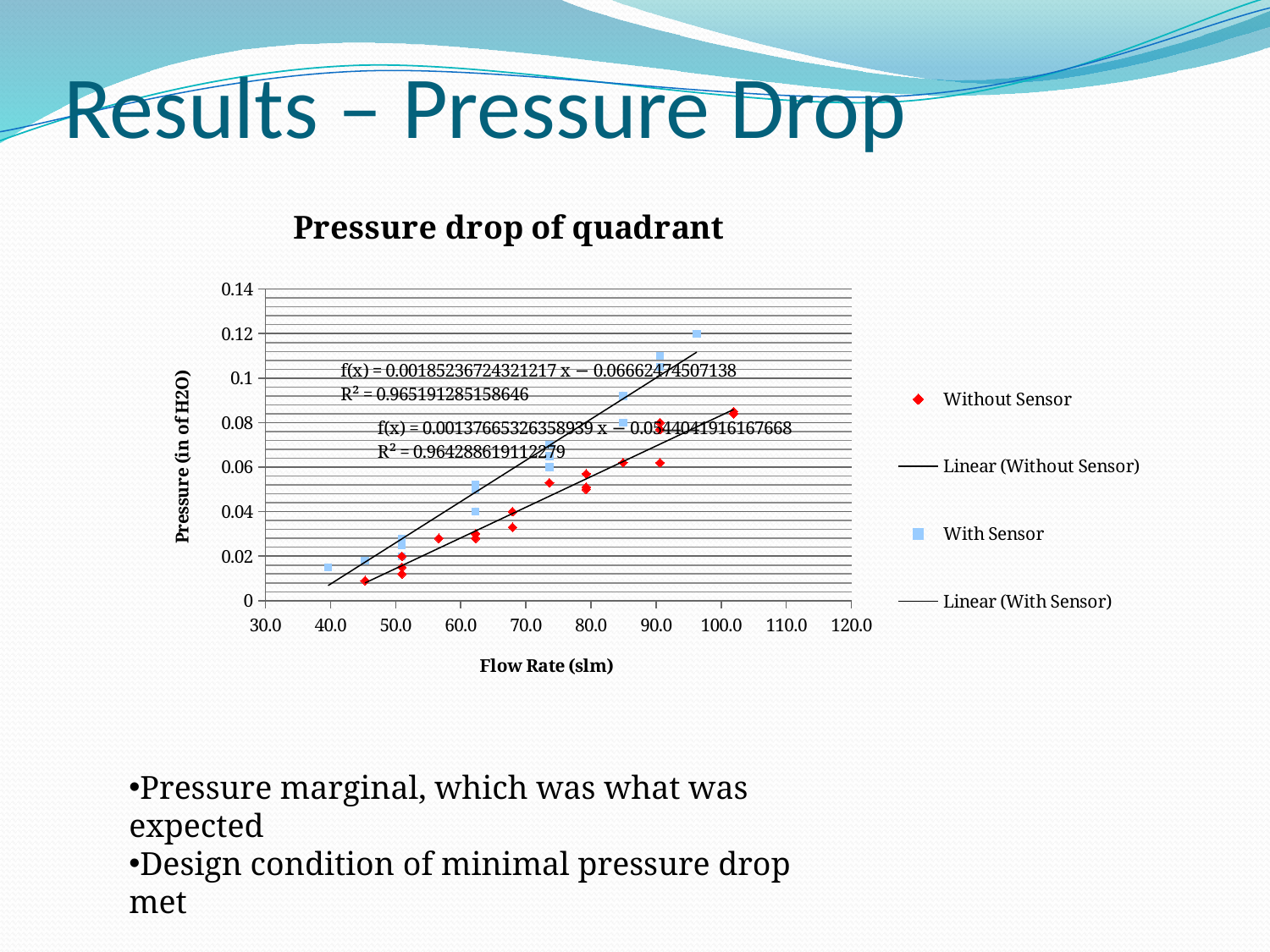
What is the label of the x axis? Flow Rate (slm) Do the pressure values rise or fall as flow rate increases? rise What is the R² value printed for the upper trendline equation (f(x) = 0.00185236724321217 x − 0.0666247450713)? 0.965191285158646 What kind of chart is shown on the slide? scatter chart What is the title of the chart? Pressure drop of quadrant Is the pressure for the Without Sensor point at about 45 slm greater or less than 0.02? less What is the R² value printed for the lower trendline equation (f(x) = 0.00137665326358939 x − ...)? 0.964288619112279 What is the maximum value shown on the y axis? 0.14 How many entries does the chart legend list? 4 Is the pressure for the With Sensor point at the lowest flow rate (about 40 slm) greater or less than 0.02? less Which series has the higher pressure at a flow rate of about 85 slm, With Sensor or Without Sensor? With Sensor Is the pressure for the Without Sensor point at the highest flow rate (about 102 slm) greater or less than 0.08? greater